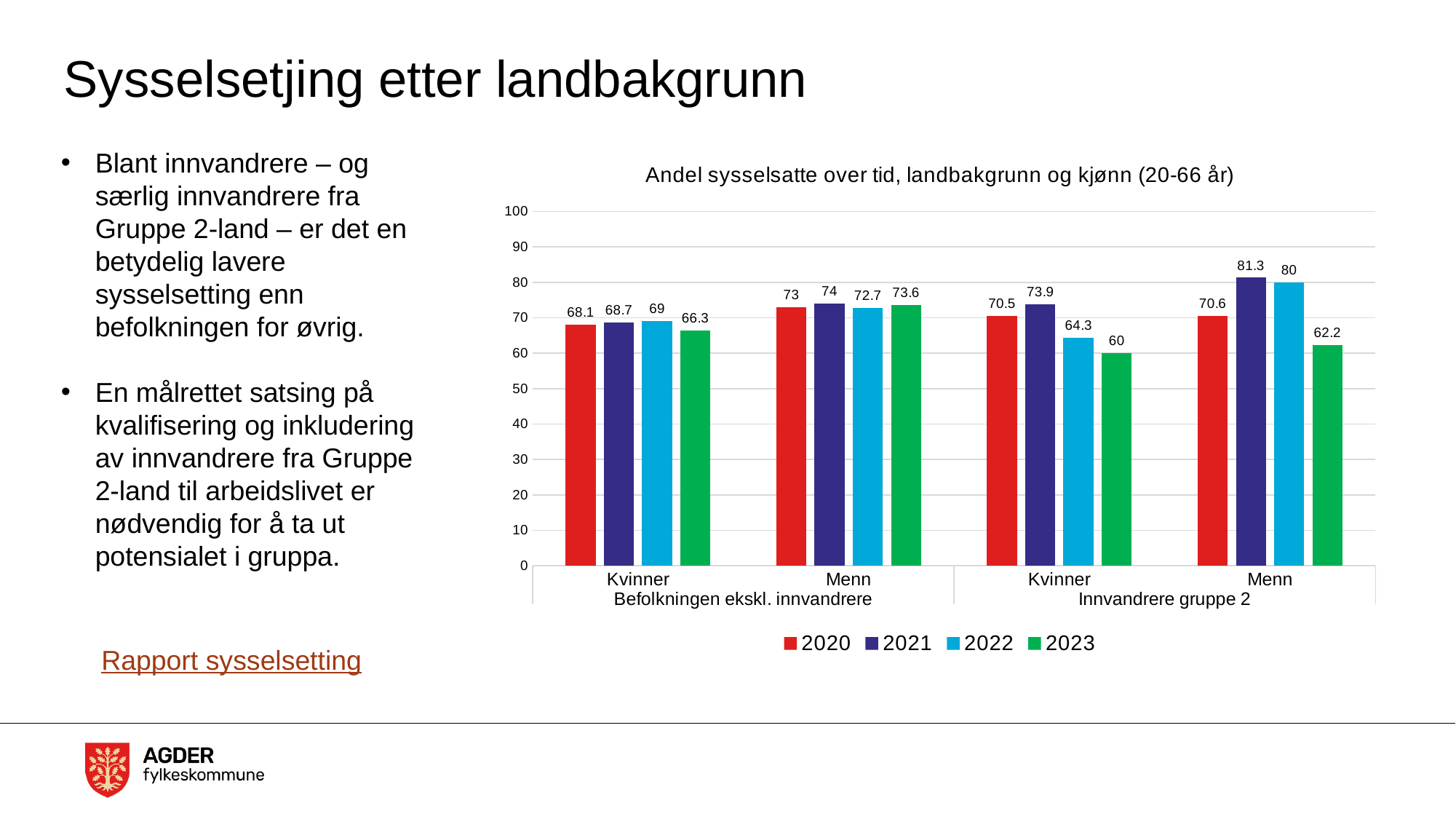
What is the difference between the 2021 and 2023 values for Menn in the Innvandrere gruppe 2 group? 19.1 What is the 2023 value for Kvinner in the Innvandrere gruppe 2 group? 60 What kind of chart is shown on the slide? Bar chart Which bar has the lowest value in the chart? 2023, Kvinner, Innvandrere gruppe 2 Which bar has the highest value in the chart? 2021, Menn, Innvandrere gruppe 2 What is the 2020 value for Kvinner in the Befolkningen ekskl. innvandrere group? 68.1 Do the values for Kvinner in the Innvandrere gruppe 2 group rise or fall from 2021 to 2023? Fall What is the 2021 value for Menn in the Innvandrere gruppe 2 group? 81.3 How many series does the legend list? 4 What is the 2022 value for Menn in the Befolkningen ekskl. innvandrere group? 72.7 What is the title of the chart? Andel sysselsatte over tid, landbakgrunn og kjønn (20-66 år) Which is larger: the 2022 value for Kvinner in Befolkningen ekskl. innvandrere or the 2022 value for Kvinner in Innvandrere gruppe 2? Kvinner in Befolkningen ekskl. innvandrere